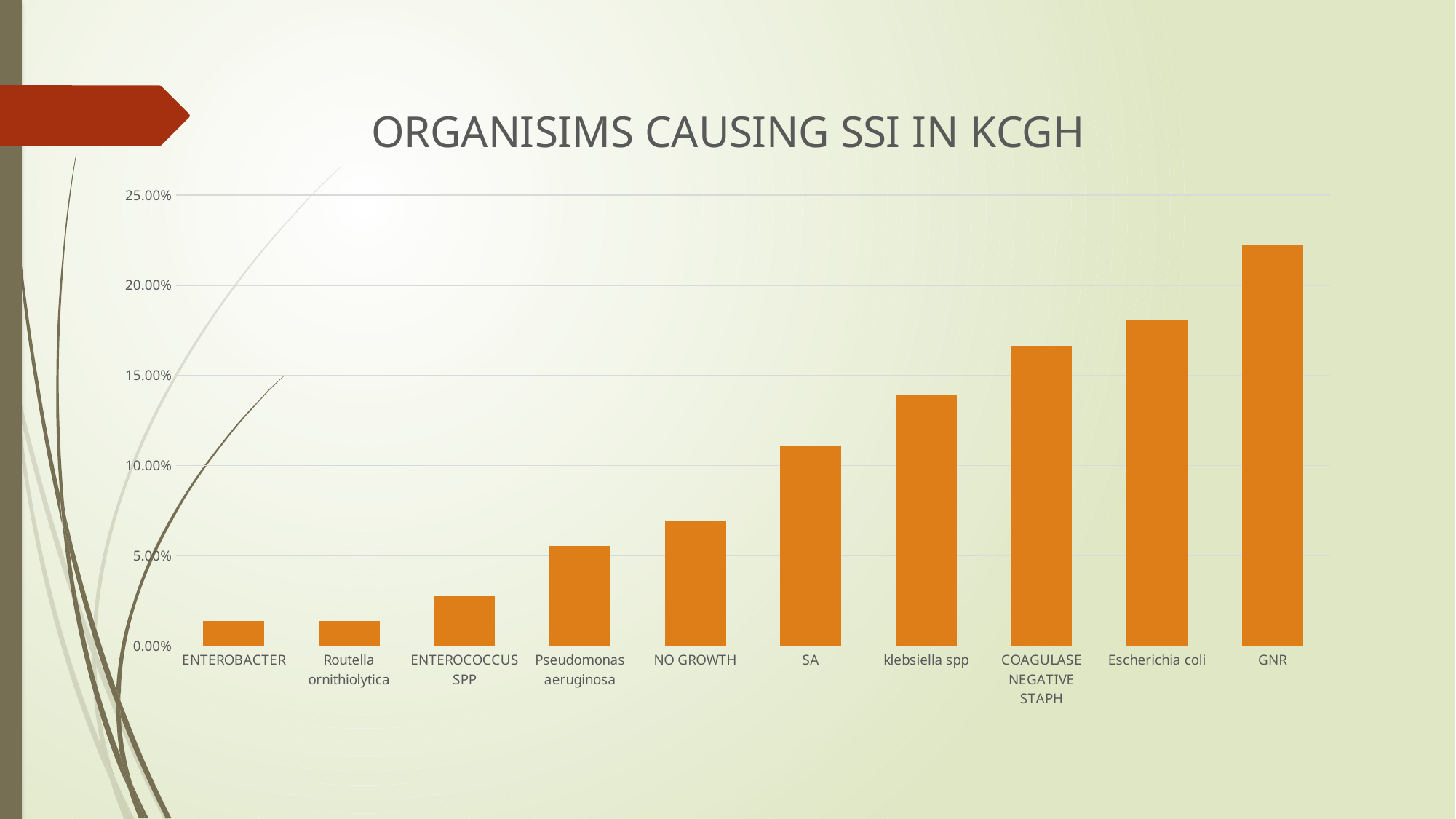
Which organism has the highest percentage? GNR What type of chart is shown on the slide? Bar chart Which is larger, the value for COAGULASE NEGATIVE STAPH or the value for SA? COAGULASE NEGATIVE STAPH Is the value for klebsiella spp greater or less than 15.00%? less Do the values generally rise or fall from left to right along the x axis? Rise Is the value for Escherichia coli greater or less than 20.00%? less Is the value for ENTEROCOCCUS SPP greater or less than 5.00%? less How many organism categories are shown on the x axis? 10 What is the title of the chart? ORGANISIMS CAUSING SSI IN KCGH